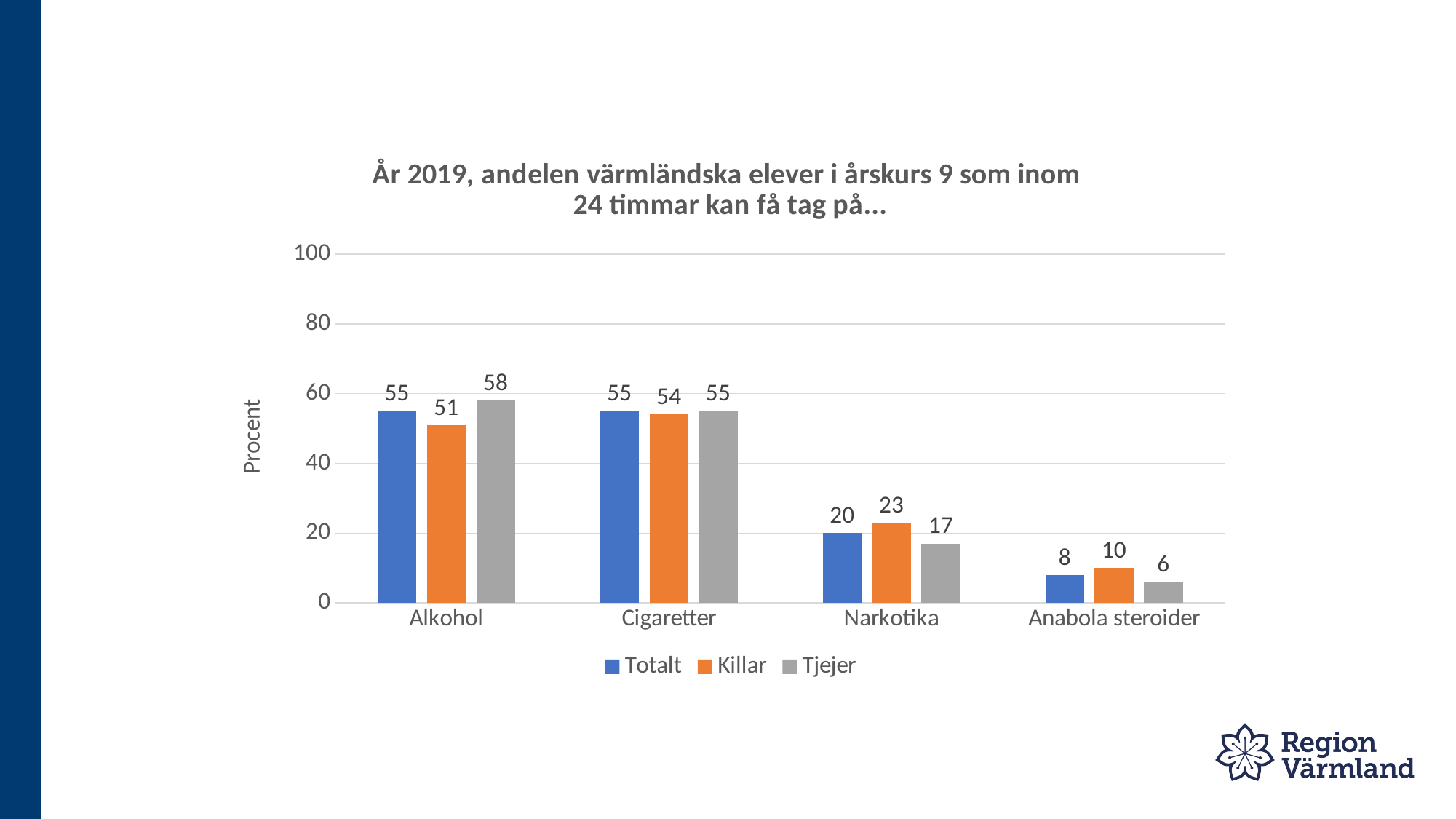
What is the value for Killar in the Narkotika category? 23 Which is larger for Anabola steroider, the Killar value or the Tjejer value? Killar What kind of chart is shown on the slide? Bar chart Which series has the highest value in the Alkohol category? Tjejer How many series does the legend list? 3 What is the label of the y axis? Procent Which category has the lowest Totalt value? Anabola steroider What is the difference between the Killar and Tjejer values for Narkotika? 6 How many categories are shown on the x axis? 4 What is the Totalt value for Anabola steroider? 8 What is the difference between the Tjejer and Killar values for Alkohol? 7 What is the value for Tjejer in the Alkohol category? 58